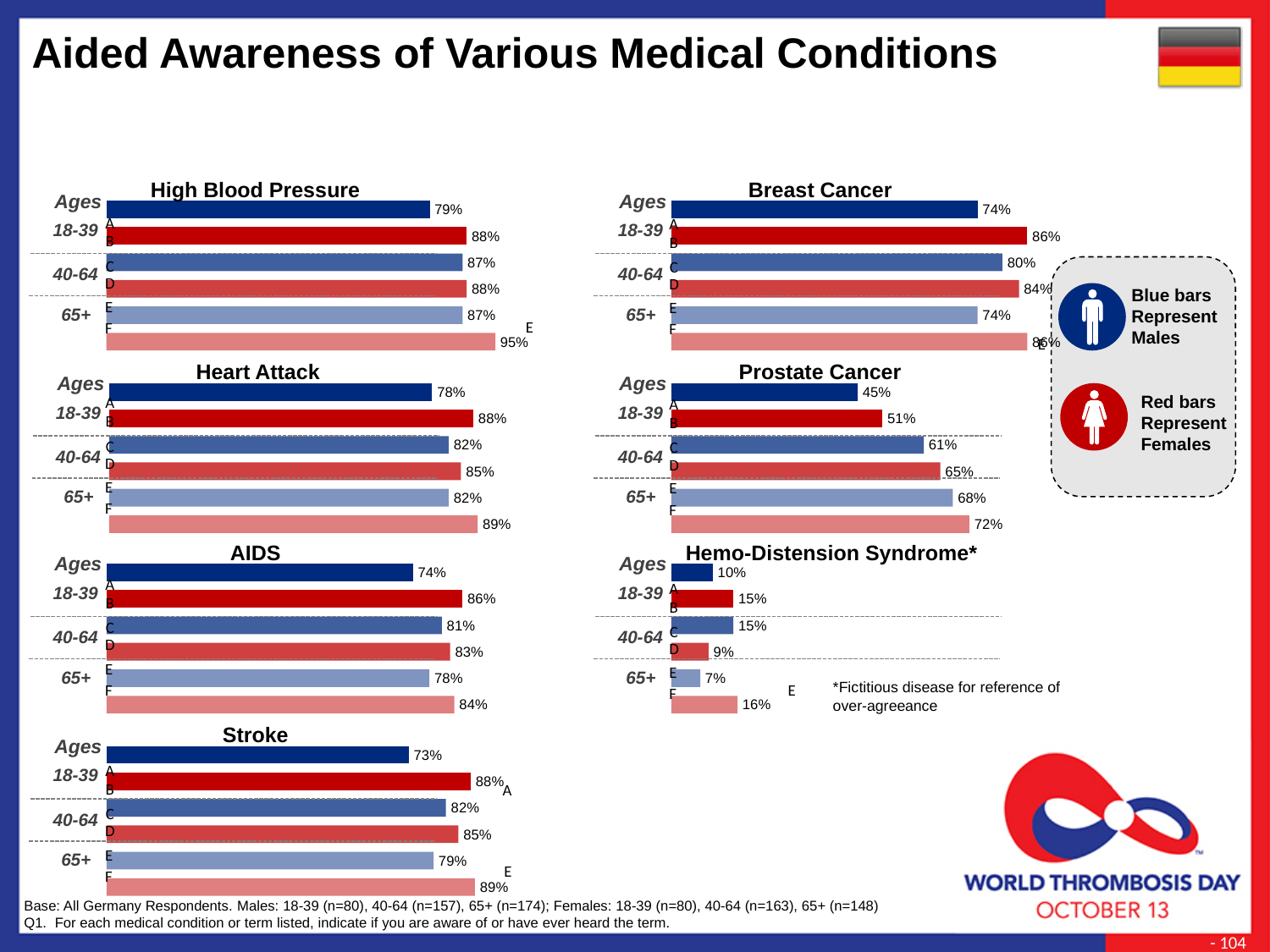
In the Hemo-Distension Syndrome chart, what is the value for males aged 65+? 7% In the High Blood Pressure chart, what is the value for females aged 65+? 95% In the AIDS chart, which group has the lowest awareness? Males aged 18-39 In the Hemo-Distension Syndrome chart, which is larger: females aged 40-64 or males aged 40-64? Males aged 40-64 In the Stroke chart, what is the value for females aged 65+? 89% In the Prostate Cancer chart, which group has the highest awareness? Females aged 65+ In the Prostate Cancer chart, do male values rise or fall as age increases from 18-39 to 65+? Rise In the Heart Attack chart, what is the difference between females aged 18-39 and males aged 18-39? 10% What type of chart is used for the Stroke data? Bar chart In the Prostate Cancer chart, what is the value for males aged 18-39? 45% In the High Blood Pressure chart, what is the value for males aged 18-39? 79% In the Breast Cancer chart, what is the value for males aged 40-64? 80%